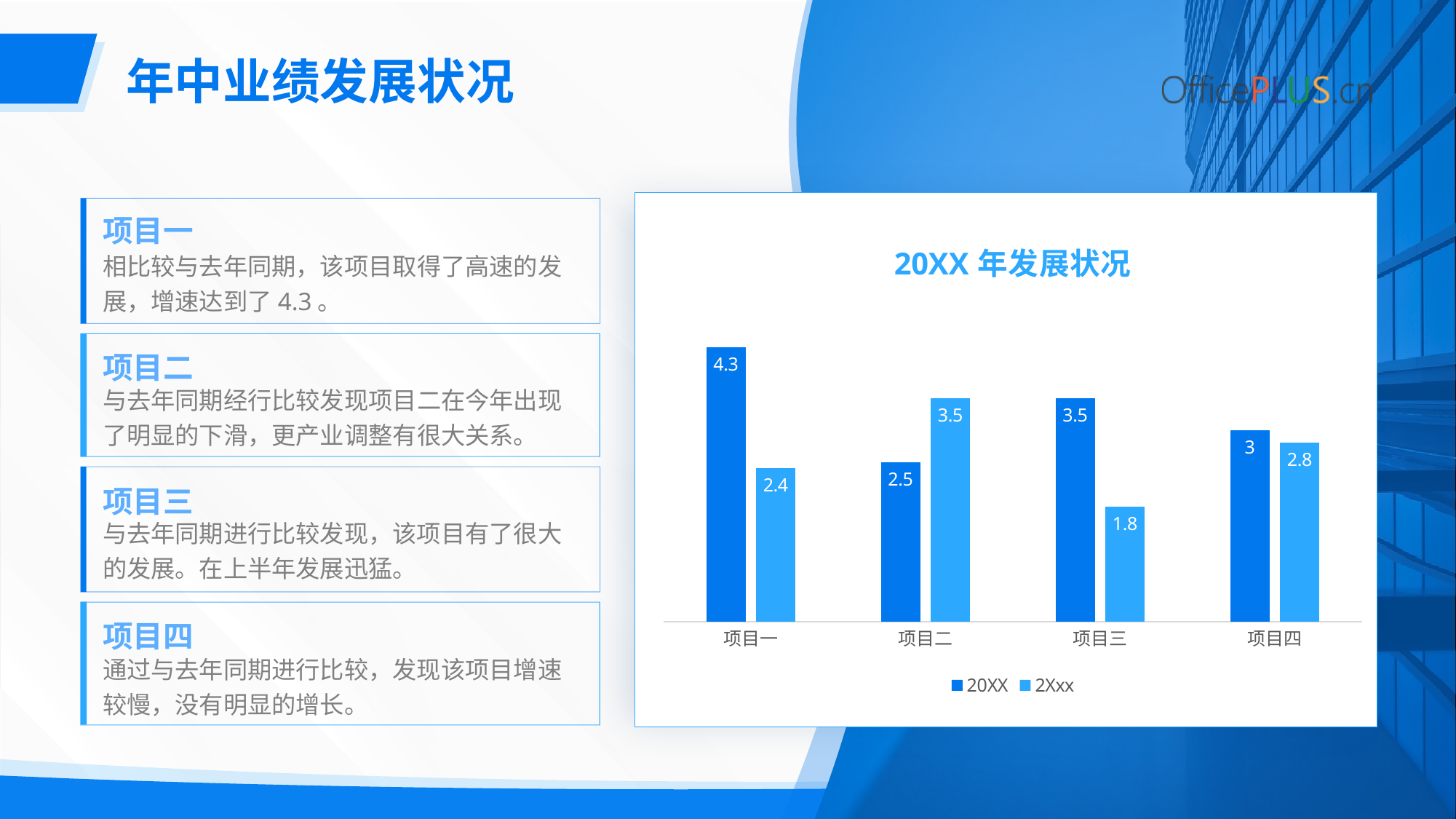
What is the difference between the 20XX and 2Xxx values for 项目一? 1.9 What kind of chart is shown on the slide? Bar chart For 项目二, which series has the larger value, 20XX or 2Xxx? 2Xxx Which category has the highest value in the 20XX series? 项目一 Which category has the lowest value in the 2Xxx series? 项目三 What is the title of the chart? 20XX 年发展状况 How many series does the legend list? 2 How many categories are shown on the x axis? 4 What is the value for 项目三 in the 2Xxx series? 1.8 What is the difference between the 2Xxx and 20XX values for 项目二? 1 What is the value for 项目一 in the 20XX series? 4.3 What is the value for 项目四 in the 20XX series? 3